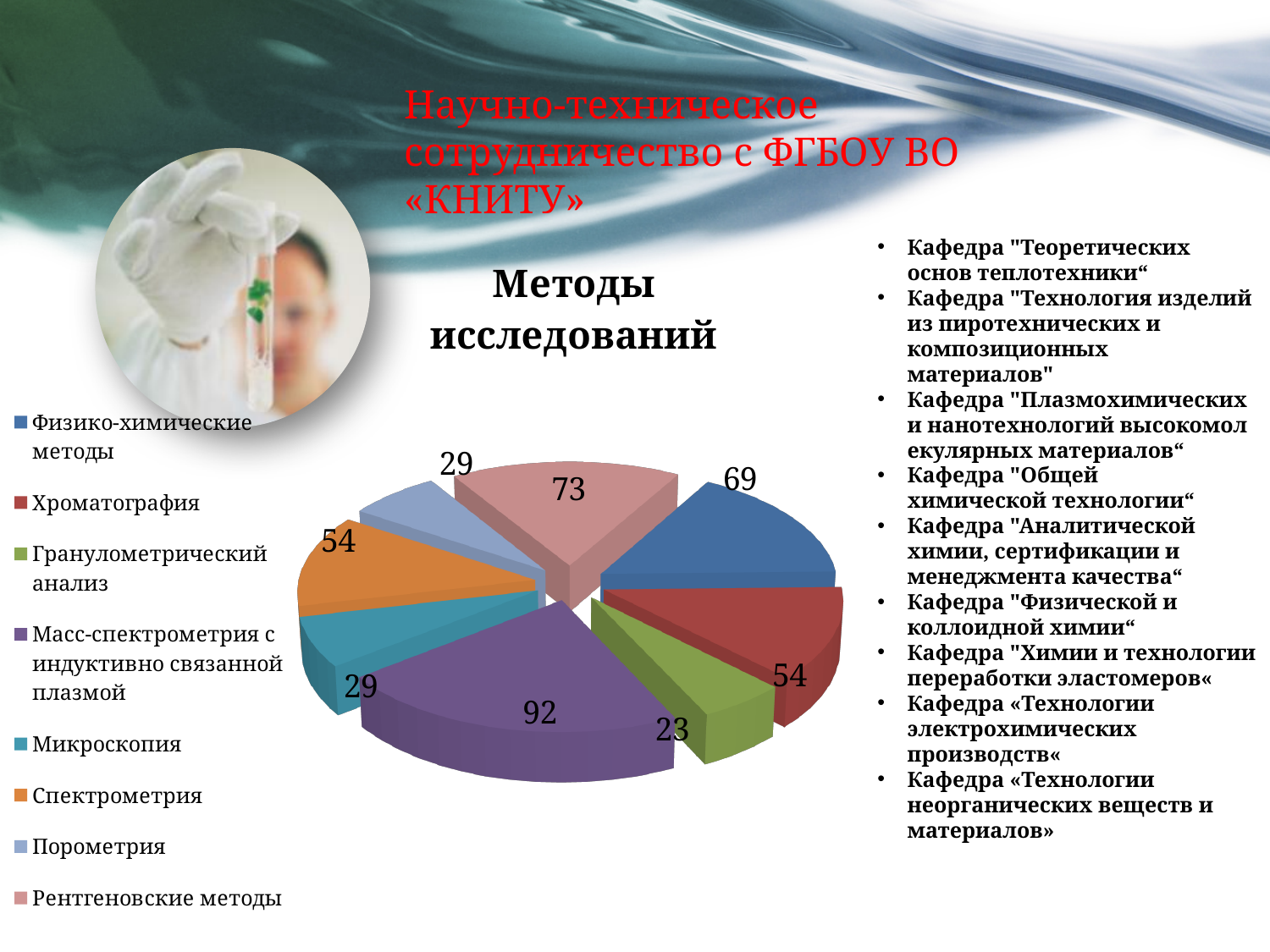
What is the difference between the values for "Масс-спектрометрия с индуктивно связанной плазмой" and "Рентгеновские методы"? 19 What is the value for "Физико-химические методы" in the pie chart? 69 What colour is the "Спектрометрия" slice in the pie chart? orange Which is larger in the pie chart: "Физико-химические методы" or "Хроматография"? Физико-химические методы What is the value for "Гранулометрический анализ" in the pie chart? 23 Which category has the smallest slice in the "Методы исследований" pie chart? Гранулометрический анализ What kind of chart is shown under the title "Методы исследований"? pie chart What is the sum of all the values shown in the "Методы исследований" pie chart? 423 How many categories does the legend of the "Методы исследований" pie chart list? 8 Which category has the largest slice in the "Методы исследований" pie chart? Масс-спектрометрия с индуктивно связанной плазмой What is the value for "Рентгеновские методы" in the pie chart? 73 What is the value for "Масс-спектрометрия с индуктивно связанной плазмой" in the pie chart? 92